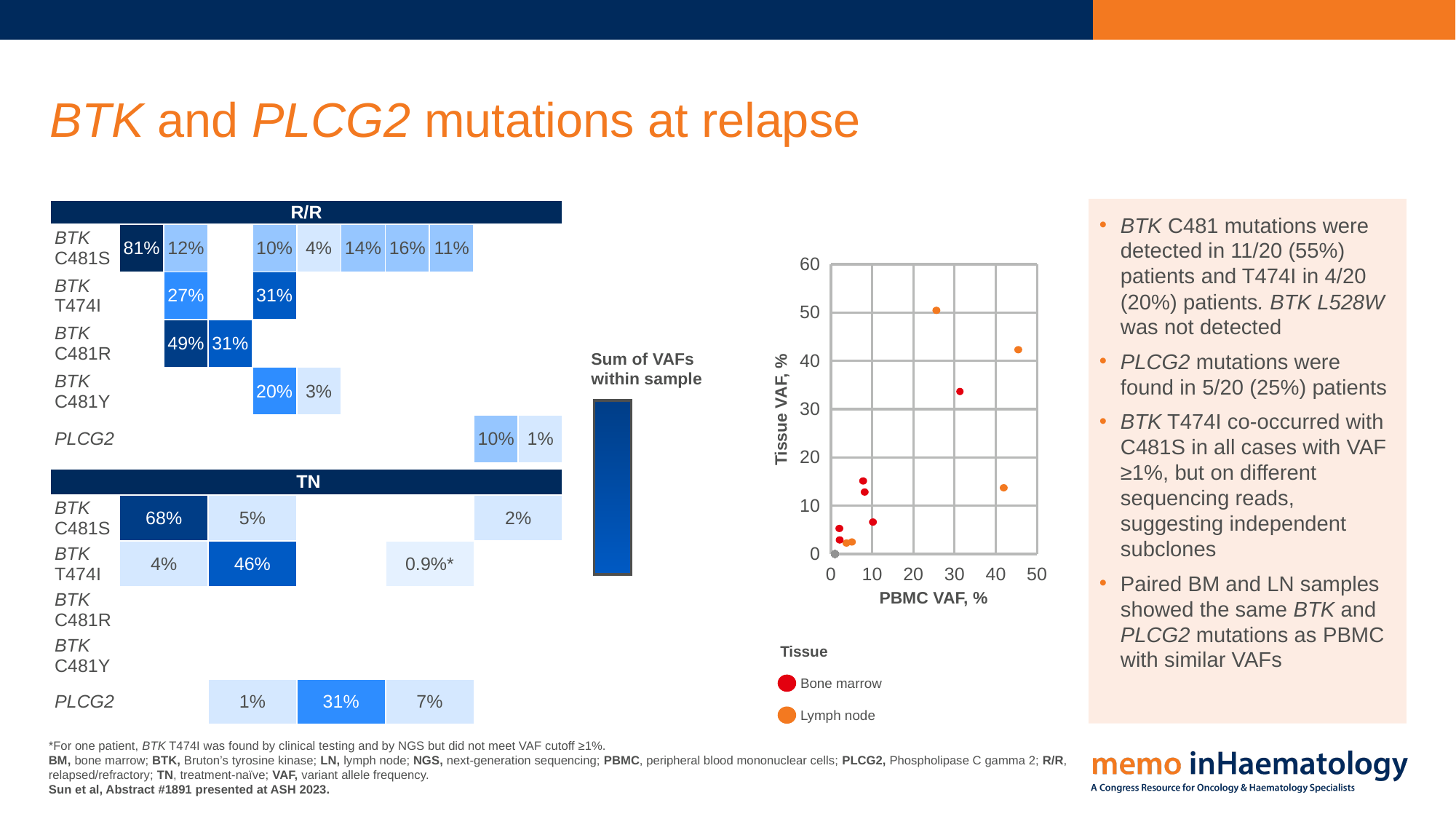
In the TN heatmap, what is the highest VAF shown for PLCG2? 31% In the TN heatmap, what is the highest VAF shown for BTK T474I? 46% How many tissue types does the legend of the scatter plot list? 2 In the scatter plot, is the PBMC VAF of the highest lymph node point greater or less than 20? greater In the scatter plot, is the tissue VAF of the highest lymph node point greater or less than 40? greater In the R/R heatmap, how many samples have a VAF value shown for BTK C481S? 7 What is the label of the x axis of the scatter plot? PBMC VAF, % What are the two tissue types listed in the scatter plot legend? Bone marrow and Lymph node In the R/R heatmap, what is the highest VAF shown for BTK C481S? 81% In the R/R heatmap, what are the two VAF values shown for BTK C481R? 49% and 31% What kind of chart is the plot of Tissue VAF against PBMC VAF? Scatter plot What is the difference between the highest BTK C481S VAF in the R/R group (81%) and the highest in the TN group (68%)? 13 percentage points